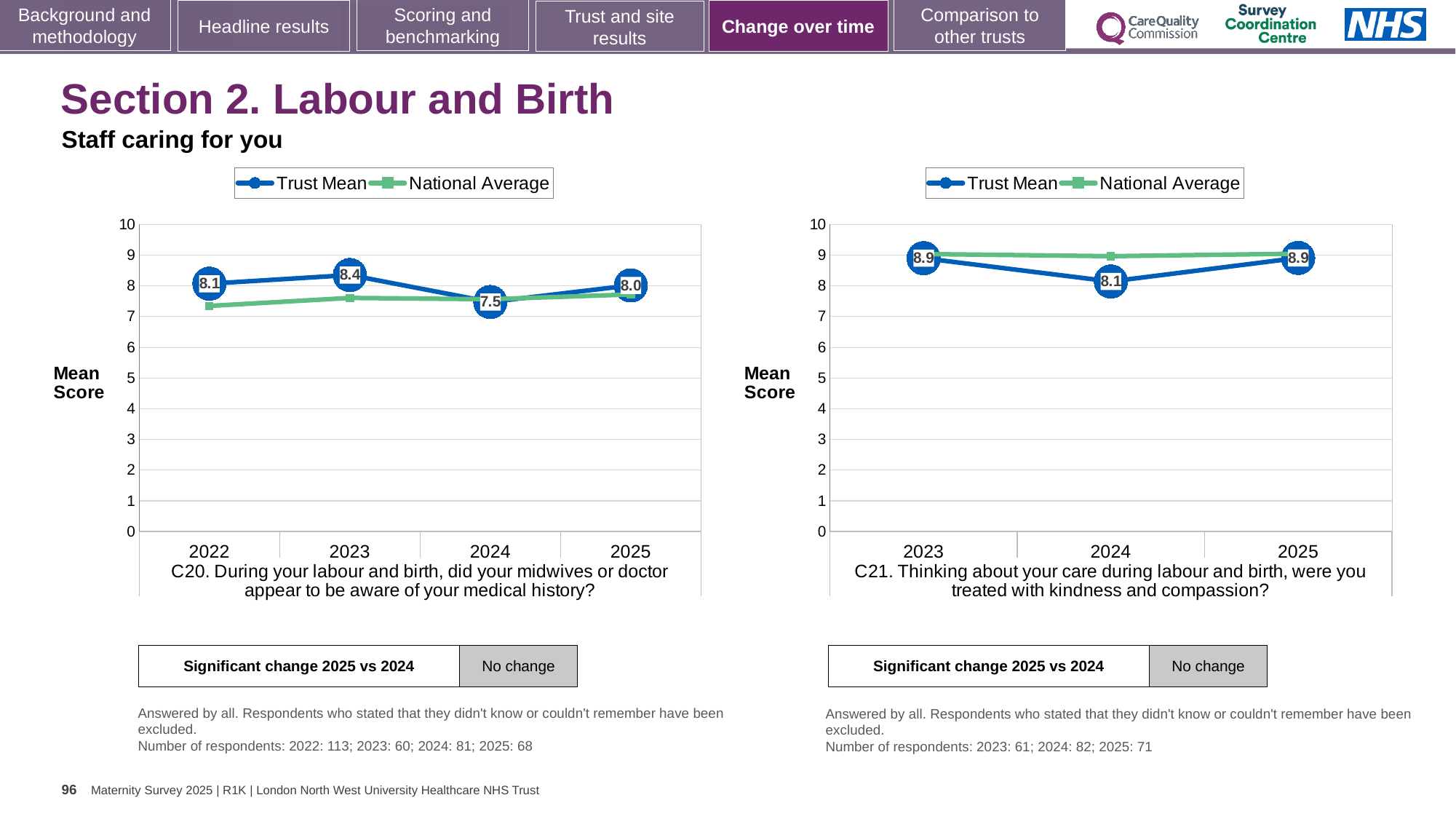
How many series does the legend of the C20 chart (left) list? 2 In the C21 chart (right), is the National Average for 2024 greater or less than 8? greater In the C20 chart (left), what is the Trust Mean for 2024? 7.5 In the C20 chart (left), what is the Trust Mean for 2023? 8.4 In the C20 chart (left), which year has the lowest Trust Mean? 2024 In the C20 chart (left), which year has the highest Trust Mean? 2023 In the C20 chart (left), is the Trust Mean higher in 2022 or in 2025? 2022 How many years are shown on the x axis of the C21 chart (right)? 3 In the C21 chart (right), which year has the lowest Trust Mean? 2024 In the C20 chart (left), what is the difference between the Trust Mean in 2023 and in 2024? 0.9 In the C21 chart (right), what is the Trust Mean for 2024? 8.1 In the C21 chart (right), what is the difference between the Trust Mean in 2023 and in 2024? 0.8